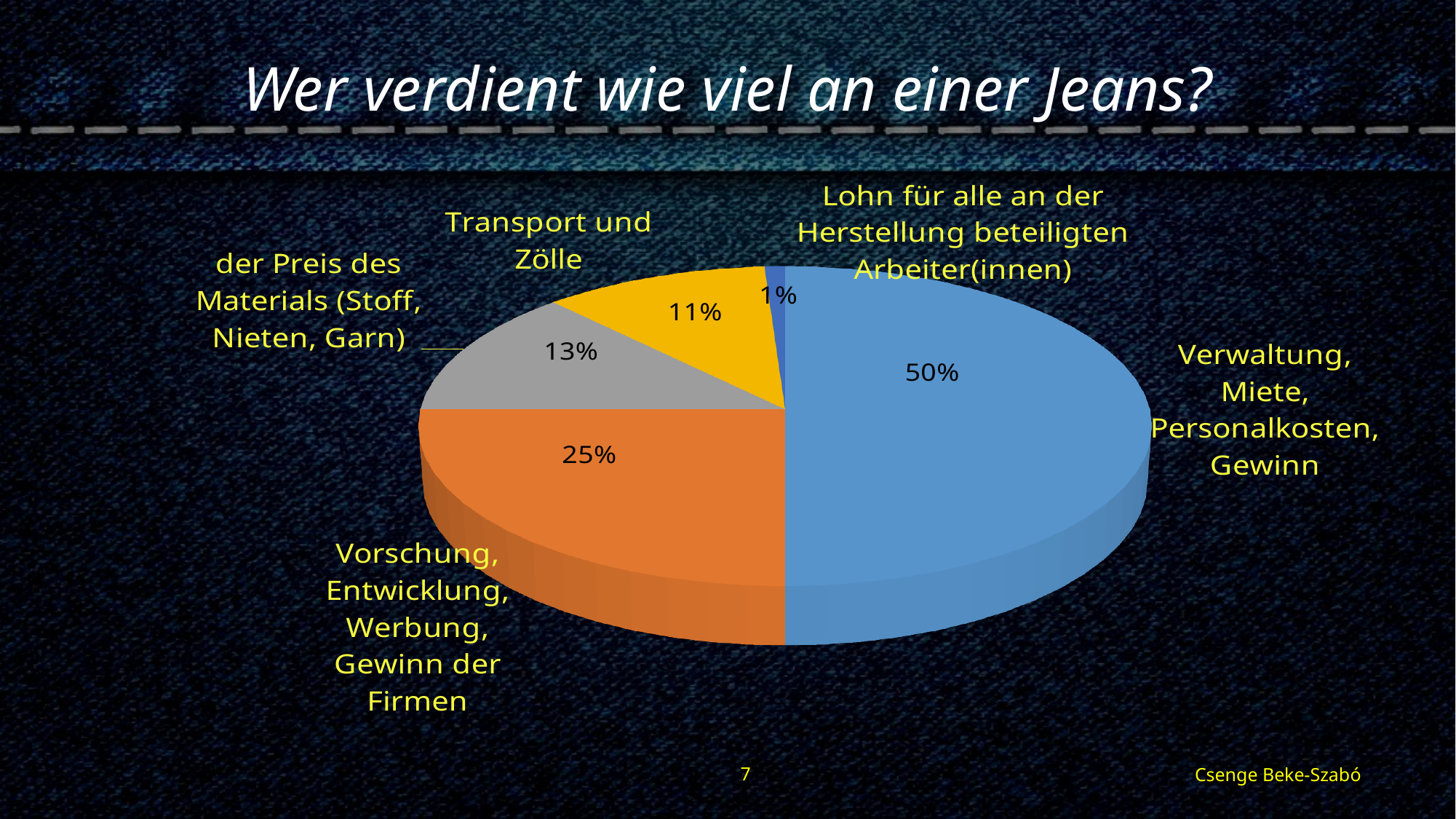
What share of the pie does "der Preis des Materials (Stoff, Nieten, Garn)" take? 13% What is the difference in percentage points between "Verwaltung, Miete, Personalkosten, Gewinn" and "Vorschung, Entwicklung, Werbung, Gewinn der Firmen"? 25% What kind of chart is shown on the slide? Pie chart Which category has the smallest slice of the pie? Lohn für alle an der Herstellung beteiligten Arbeiter(innen) What share of the pie does "Lohn für alle an der Herstellung beteiligten Arbeiter(innen)" take? 1% What share of the pie does "Vorschung, Entwicklung, Werbung, Gewinn der Firmen" take? 25% Which category has the largest slice of the pie? Verwaltung, Miete, Personalkosten, Gewinn Which is larger: the share for "der Preis des Materials (Stoff, Nieten, Garn)" or the share for "Transport und Zölle"? der Preis des Materials (Stoff, Nieten, Garn) How many slices does the pie chart have? 5 What is the title of the slide containing the chart? Wer verdient wie viel an einer Jeans?